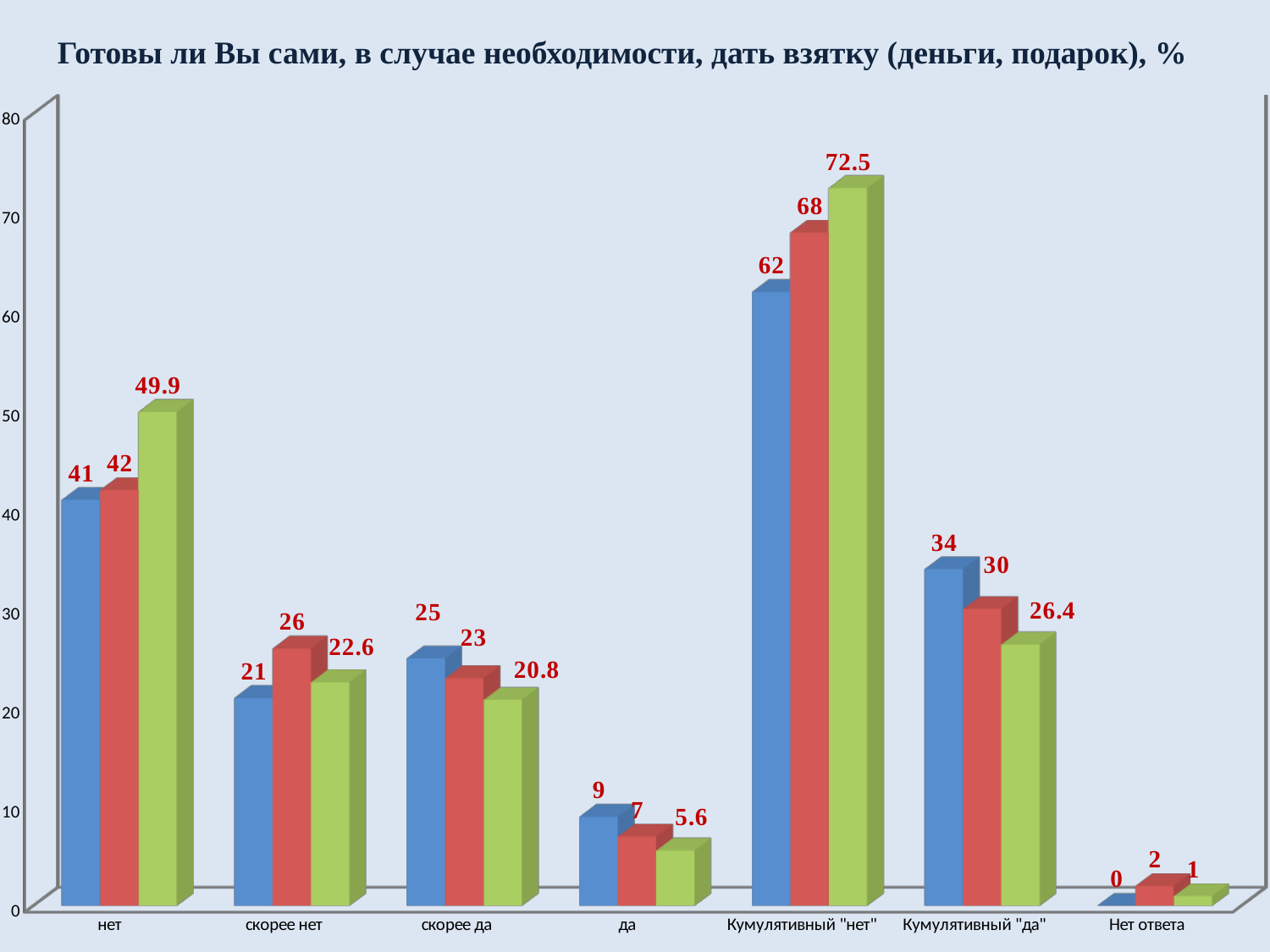
Which category has the lowest blue bar? Нет ответа What is the value of the green bar for "нет"? 49.9 What is the value of the blue bar for "Кумулятивный "нет""? 62 What type of chart is shown on the slide? bar chart What is the difference between the red bar and the blue bar for "Кумулятивный "нет""? 6 How many bars are shown for each category? 3 What is the value of the green bar for "Кумулятивный "да""? 26.4 How many categories are shown on the x axis? 7 For "скорее да", which is larger: the blue bar or the green bar? the blue bar Which category has the highest green bar? Кумулятивный "нет" What is the value of the red bar for "скорее нет"? 26 What is the title of the chart? Готовы ли Вы сами, в случае необходимости, дать взятку (деньги, подарок), %